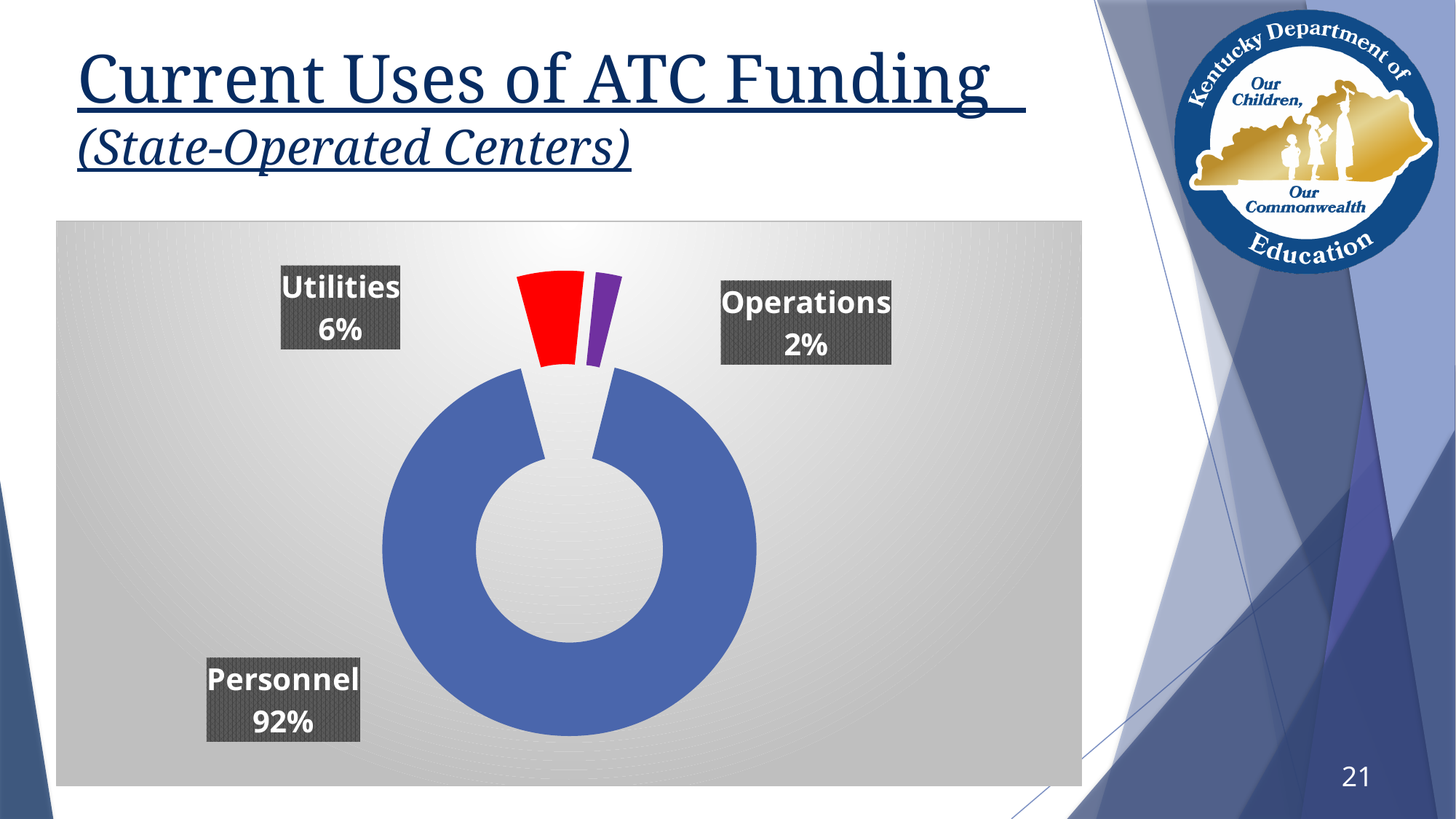
How many categories are shown in the chart? 3 What share of ATC funding goes to Personnel? 92% What share of ATC funding goes to Operations? 2% What kind of chart is shown on the slide? Doughnut (pie) chart Which category receives the smallest share of ATC funding? Operations Which category receives the largest share of ATC funding? Personnel Which is larger, the share for Utilities or the share for Operations? Utilities What share of ATC funding goes to Utilities? 6% What colour is the Personnel segment of the chart? Blue What is the difference in percentage points between the Utilities share and the Operations share? 4 What is the title of the slide containing the chart? Current Uses of ATC Funding (State-Operated Centers) What is the difference in percentage points between the Personnel share and the Utilities share? 86